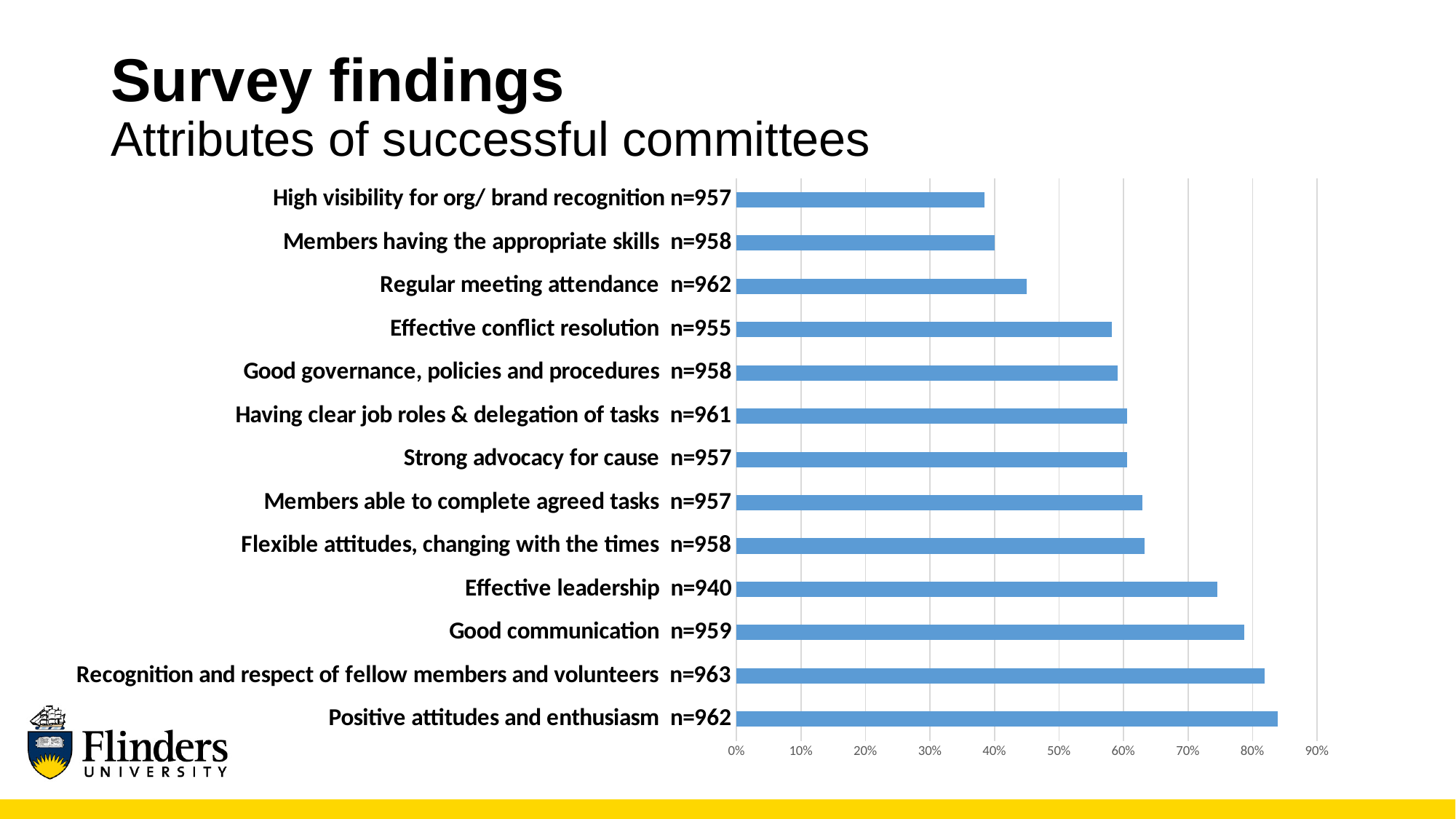
Is the value for Good communication greater or less than 70%? greater Is the value for Effective leadership greater or less than 70%? greater What is the highest percentage tick shown on the horizontal axis? 90% What is the sample size (n) shown for Effective leadership? n=940 Is the value for Recognition and respect of fellow members and volunteers greater or less than 80%? greater How many attributes (categories) are plotted in the chart? 13 What kind of chart is shown on the slide? bar chart Which has a higher value: Effective leadership or Strong advocacy for cause? Effective leadership Which has a higher value: Regular meeting attendance or Effective conflict resolution? Effective conflict resolution Which attribute has the longest bar in the chart? Positive attitudes and enthusiasm